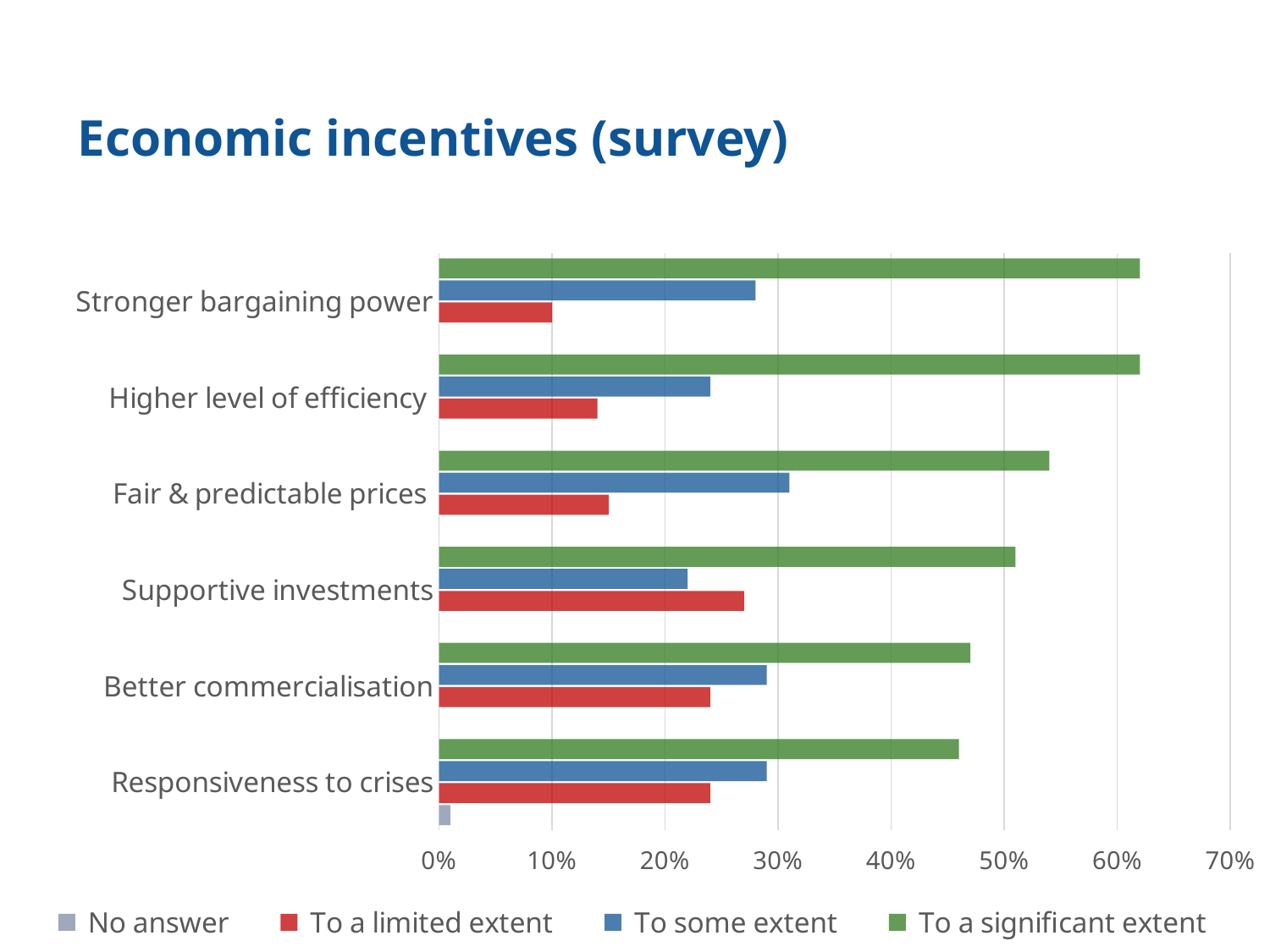
How many series does the legend list? 4 How many categories are shown on the chart? 6 What kind of chart is shown on the slide? Bar chart For Supportive investments, which is larger: 'To a limited extent' or 'To some extent'? To a limited extent Is the 'To a significant extent' value for Better commercialisation greater or less than 50%? less Is the 'To a significant extent' value for Stronger bargaining power greater or less than 60%? greater Which category has the highest 'To a limited extent' value? Supportive investments Is the 'To a limited extent' value for Supportive investments greater or less than 20%? greater Which category is the only one with a 'No answer' bar? Responsiveness to crises Which category has the lowest 'To a limited extent' value? Stronger bargaining power